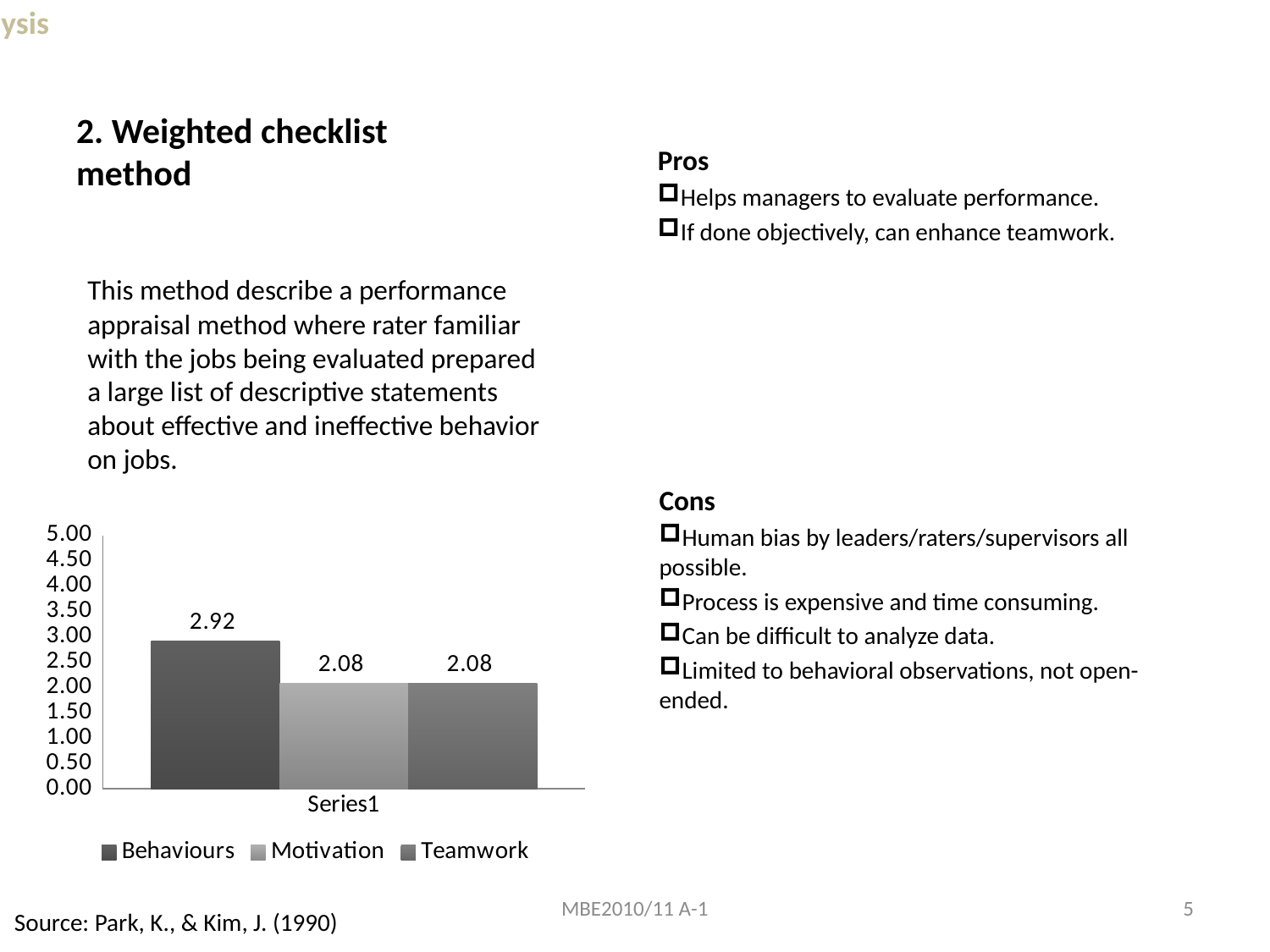
Which is larger, the value for Behaviours or the value for Teamwork? Behaviours What is the label shown on the x axis of the chart? Series1 Which series has the highest value in the chart? Behaviours Is the value for Behaviours greater or less than 2.50? greater How many series does the legend list? 3 What is the value for Teamwork in the chart? 2.08 Is the value for Motivation greater or less than 3.00? less What is the difference between the values for Behaviours and Motivation? 0.84 What is the value for Motivation in the chart? 2.08 What kind of chart is shown on the slide? Bar chart What is the highest value shown on the y axis of the chart? 5.00 What is the value for Behaviours in the chart? 2.92